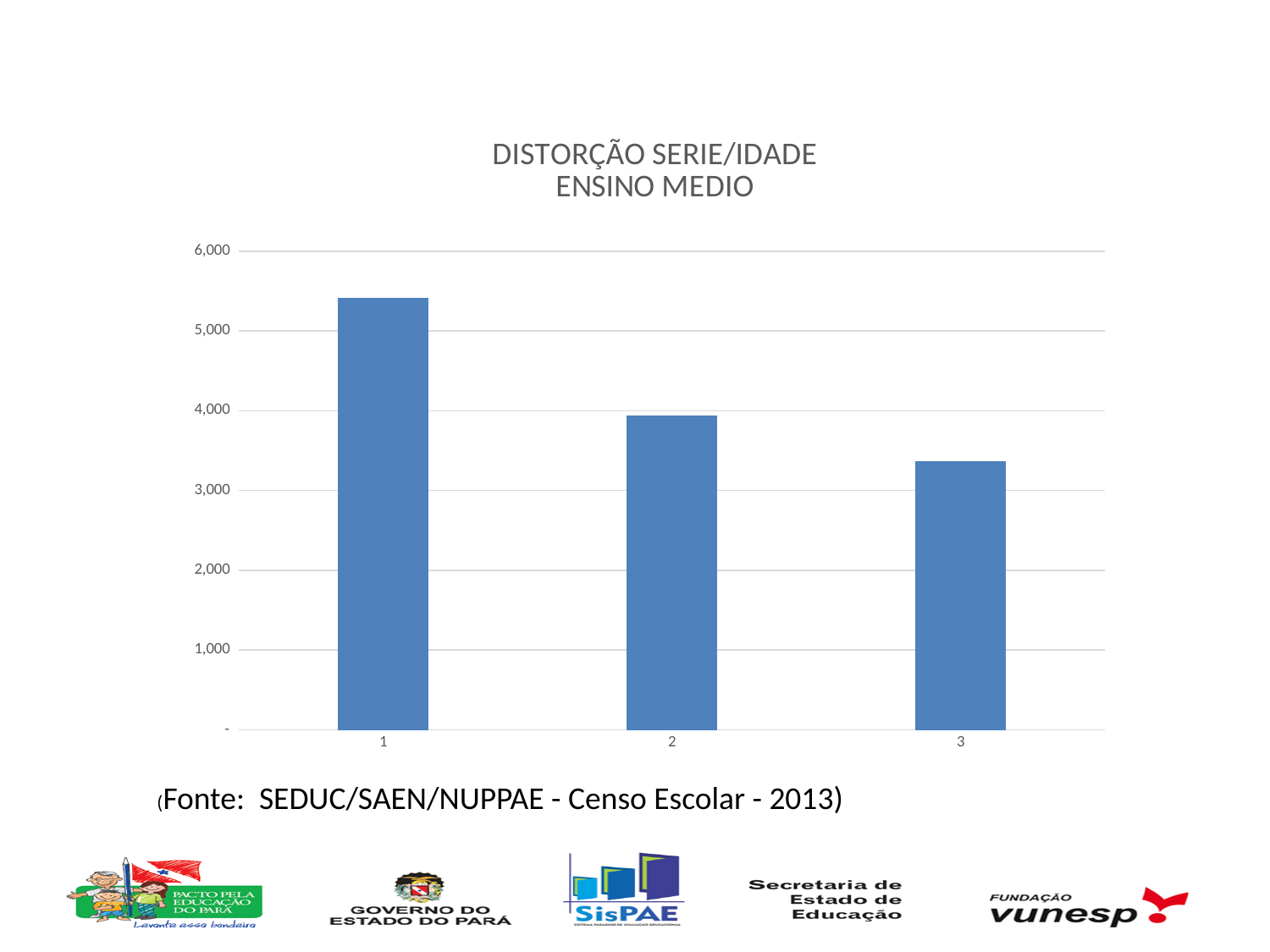
Which category has the lowest bar? 3 Is the value for category 1 greater or less than 6,000? less Which category has the highest bar? 1 What kind of chart is shown on the slide? bar chart What is the title of the chart? DISTORÇÃO SERIE/IDADE ENSINO MEDIO Is the value for category 1 greater or less than 5,000? greater How many bars are plotted in the chart? 3 Which is larger, the value for category 2 or the value for category 3? category 2 Is the value for category 3 greater or less than 3,000? greater Do the values rise or fall from category 1 to category 3? fall